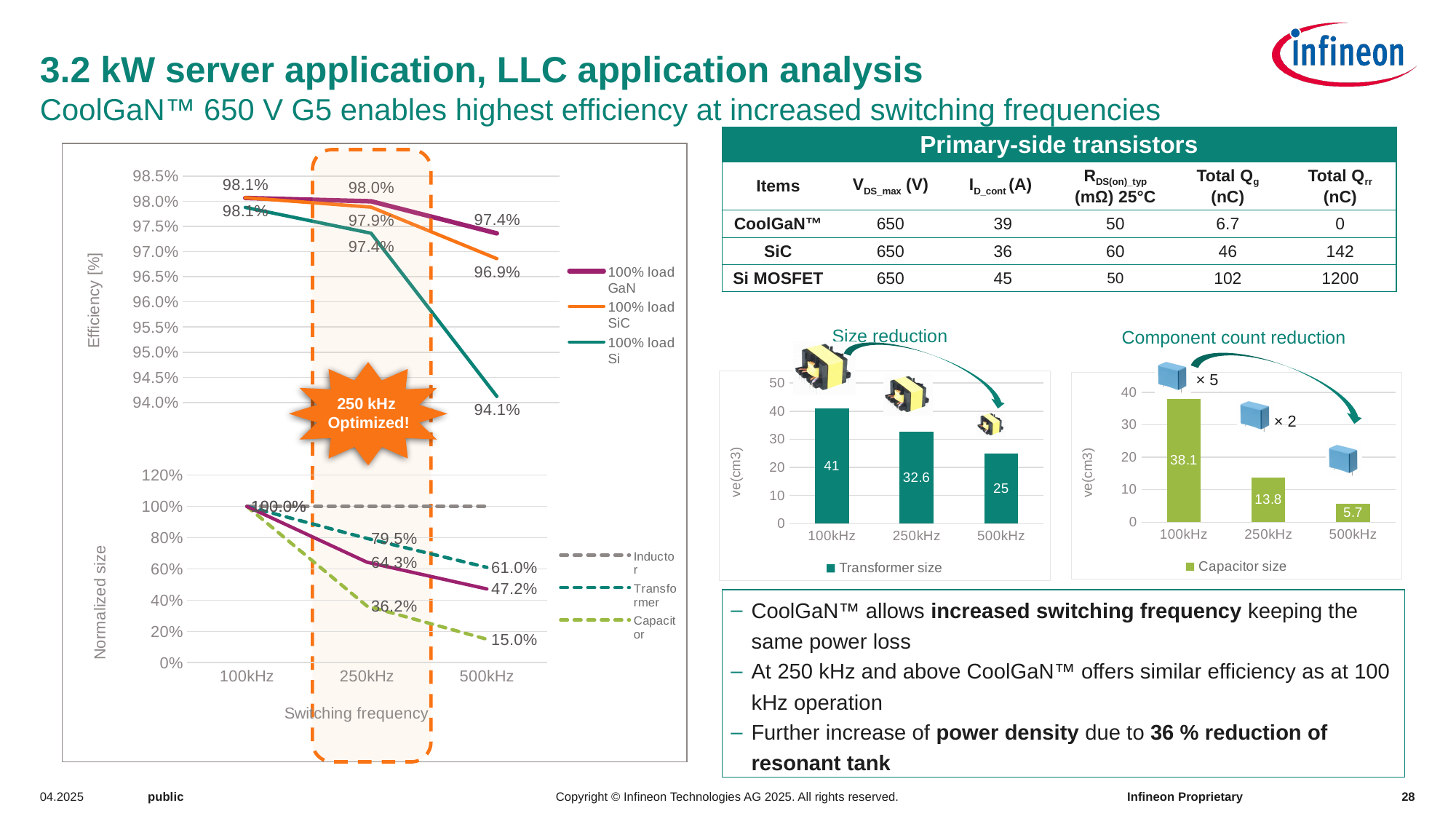
In the normalized size chart (bottom left), what is the Capacitor value at 250kHz? 36.2% In the Size reduction chart, which switching frequency has the largest transformer size? 100kHz In the efficiency chart (top left), which line has the higher efficiency at 500kHz: 100% load GaN or 100% load SiC? 100% load GaN In the Size reduction chart, what is the transformer size at 250kHz? 32.6 In the Size reduction chart, what is the difference in transformer size between 100kHz and 500kHz? 16 How many series does the legend of the efficiency chart (top left) list? 3 In the normalized size chart (bottom left), does the Transformer line rise or fall from 100kHz to 500kHz? fall In the Component count reduction chart, which switching frequency has the smallest capacitor size? 500kHz In the Component count reduction chart, what is the capacitor size at 500kHz? 5.7 In the efficiency chart (top left), what is the efficiency of the 100% load Si line at 500kHz? 94.1% In the efficiency chart (top left), what is the efficiency of the 100% load SiC line at 250kHz? 97.9% What kind of chart is the Component count reduction chart? bar chart